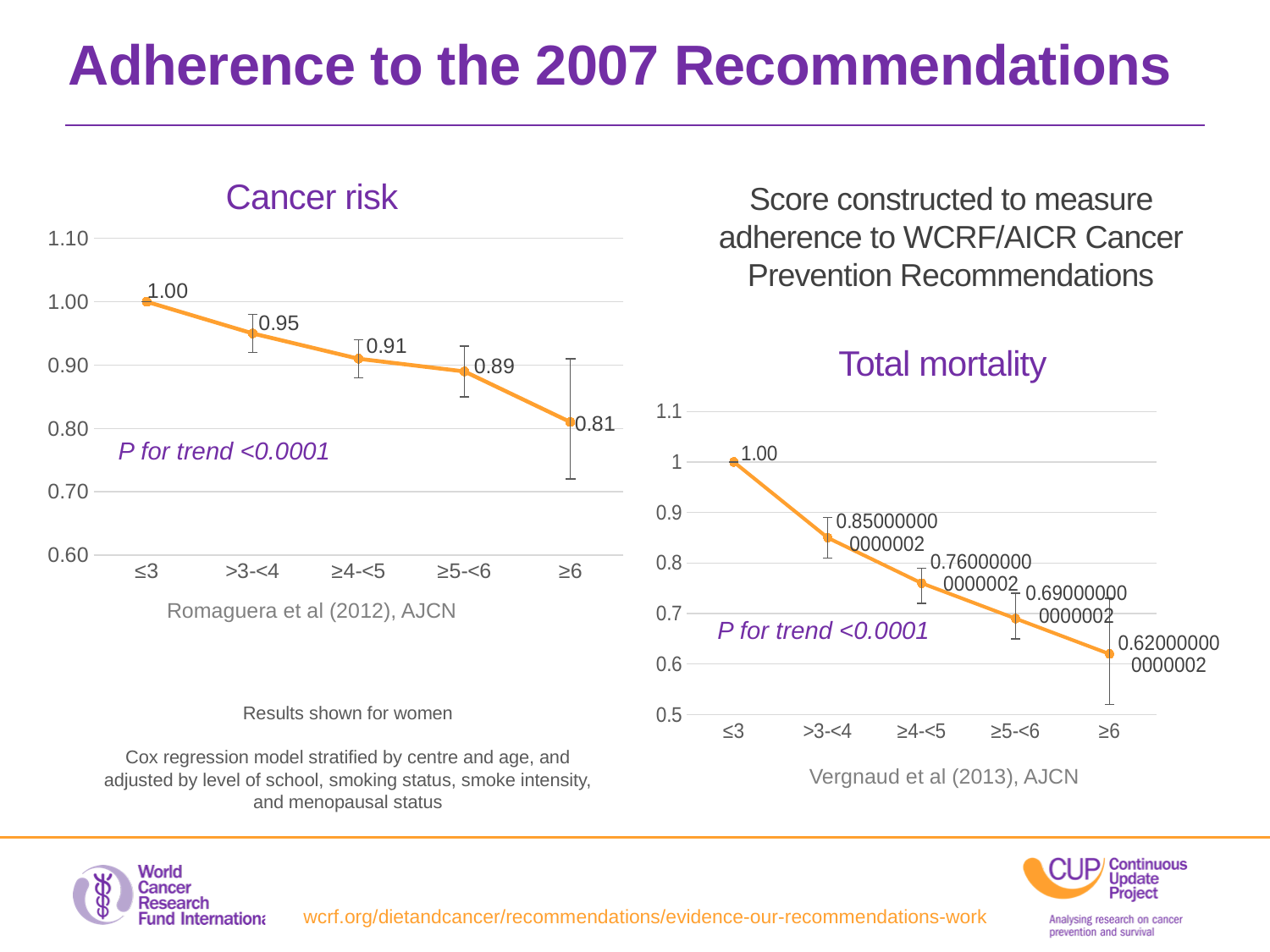
In the Total mortality chart, what is the value for the ≤3 category? 1.00 In the Cancer risk chart, what is the value for the >3-<4 category? 0.95 What is the title of the chart on the left side of the slide? Cancer risk In the Cancer risk chart, do the values rise or fall as the score increases along the x axis? fall In the Total mortality chart, which score category has the highest value? ≤3 In the Cancer risk chart, which score category has the lowest value? ≥6 In the Cancer risk chart, what is the value for the ≥6 score category? 0.81 What kind of chart is the Total mortality chart? line chart In the Cancer risk chart, what is the value for the ≥4-<5 category? 0.91 In the Total mortality chart, is the value for ≥6 greater or less than 0.7? less How many score categories are plotted in the Cancer risk chart? 5 In the Cancer risk chart, what is the difference between the values for ≤3 and ≥6? 0.19